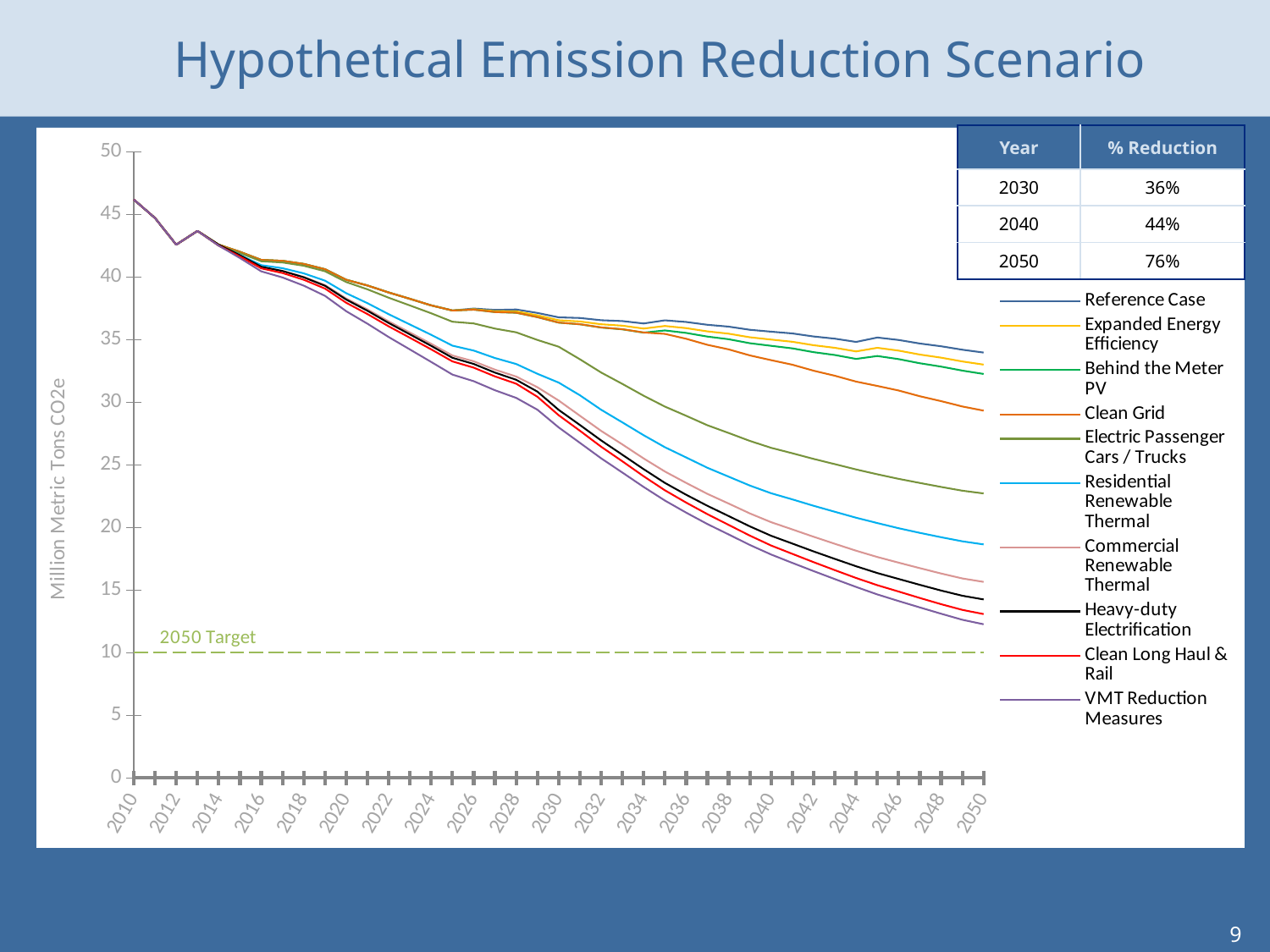
Is the value for Residential Renewable Thermal in 2050 greater or less than 20? less What is the label on the chart's y axis? Million Metric Tons CO2e Is the value for VMT Reduction Measures in 2050 greater or less than 15? less Which series has the highest value in 2050? Reference Case Is the value for Electric Passenger Cars / Trucks in 2050 greater or less than 25? less Which series has the lowest value in 2050? VMT Reduction Measures In 2050, which is higher: Behind the Meter PV or Clean Grid? Behind the Meter PV What kind of chart is shown on the slide? line chart At what value on the y axis is the dashed 2050 Target line drawn? 10 Does the Reference Case line rise or fall from 2010 to 2050? falls How many series does the chart's legend list? 10